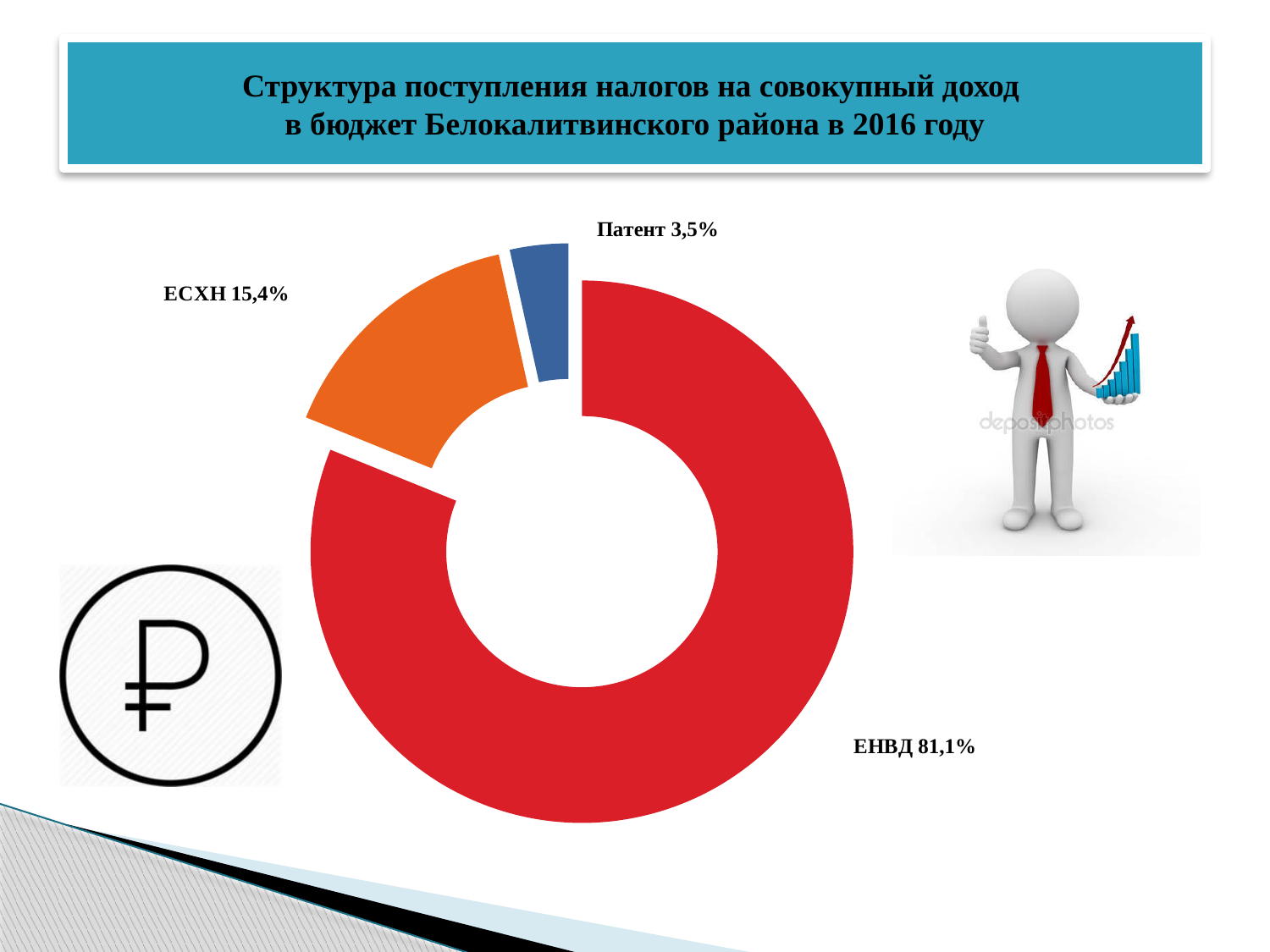
What is the value shown for Патент? 3,5% Which category has the smallest share? Патент Which is larger, the share of ЕСХН or the share of Патент? ЕСХН What is the value shown for ЕСХН? 15,4% How many categories are shown in the chart? 3 What is the difference between the shares of ЕСХН and Патент? 11,9% Which category has the largest share? ЕНВД What share of the pie does ЕНВД have? 81,1% What is the difference between the shares of ЕНВД and ЕСХН? 65,7% What year does the chart title refer to? 2016 What colour is the ЕНВД slice? Red What kind of chart is shown on the slide? Pie chart (doughnut)